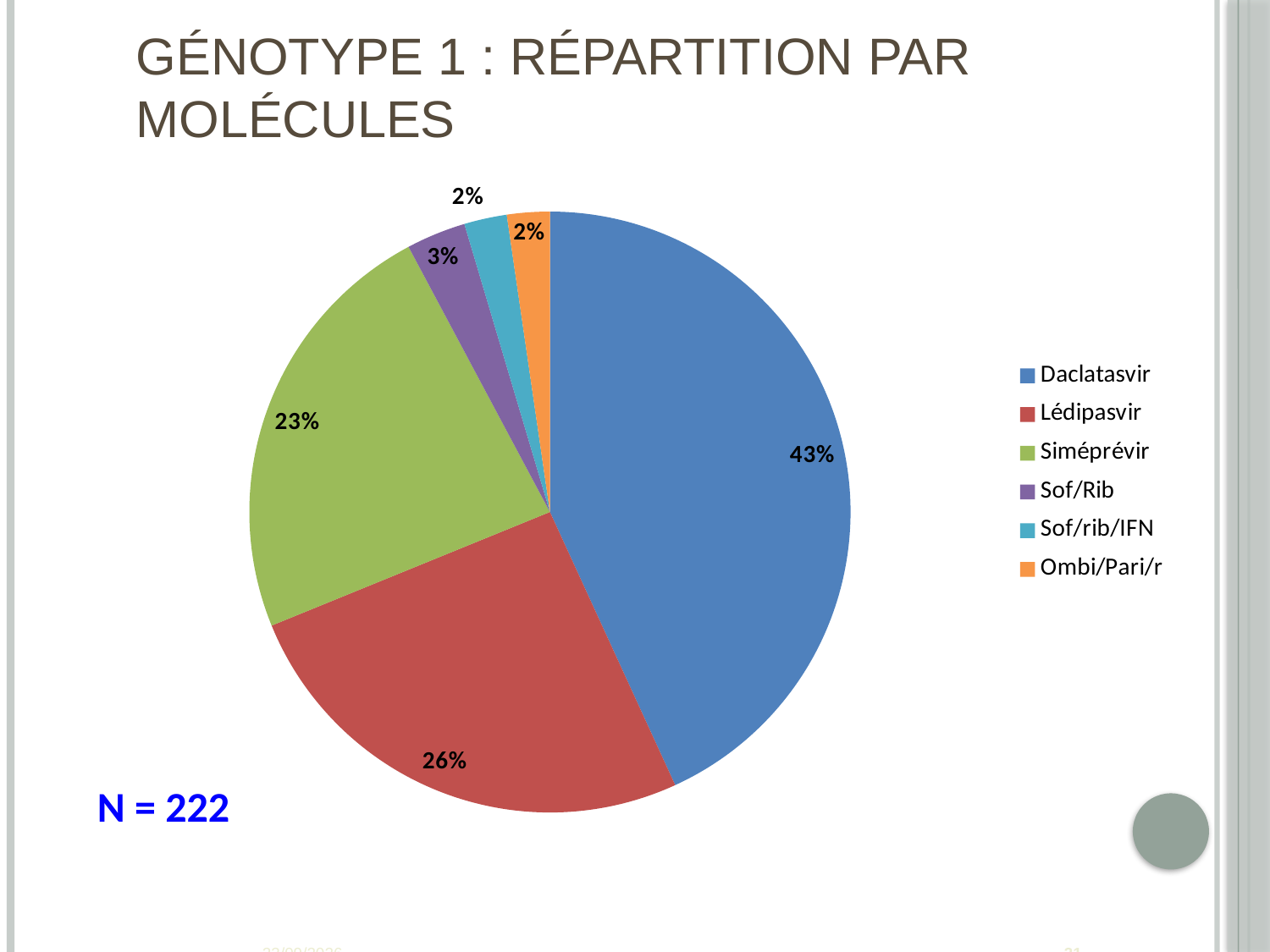
What share of the pie does Lédipasvir represent? 26% Which has a larger share, Lédipasvir or Siméprévir? Lédipasvir What share of the pie does Daclatasvir represent? 43% What is the difference in percentage points between the Daclatasvir and Lédipasvir shares? 17 What share of the pie does Siméprévir represent? 23% What type of chart is shown on the slide? pie chart What is the value of N shown on the slide? 222 What colour is the Siméprévir slice? green How many categories does the legend list? 6 What is the combined share of Daclatasvir and Lédipasvir? 69% Which molecule has the largest share of the pie? Daclatasvir